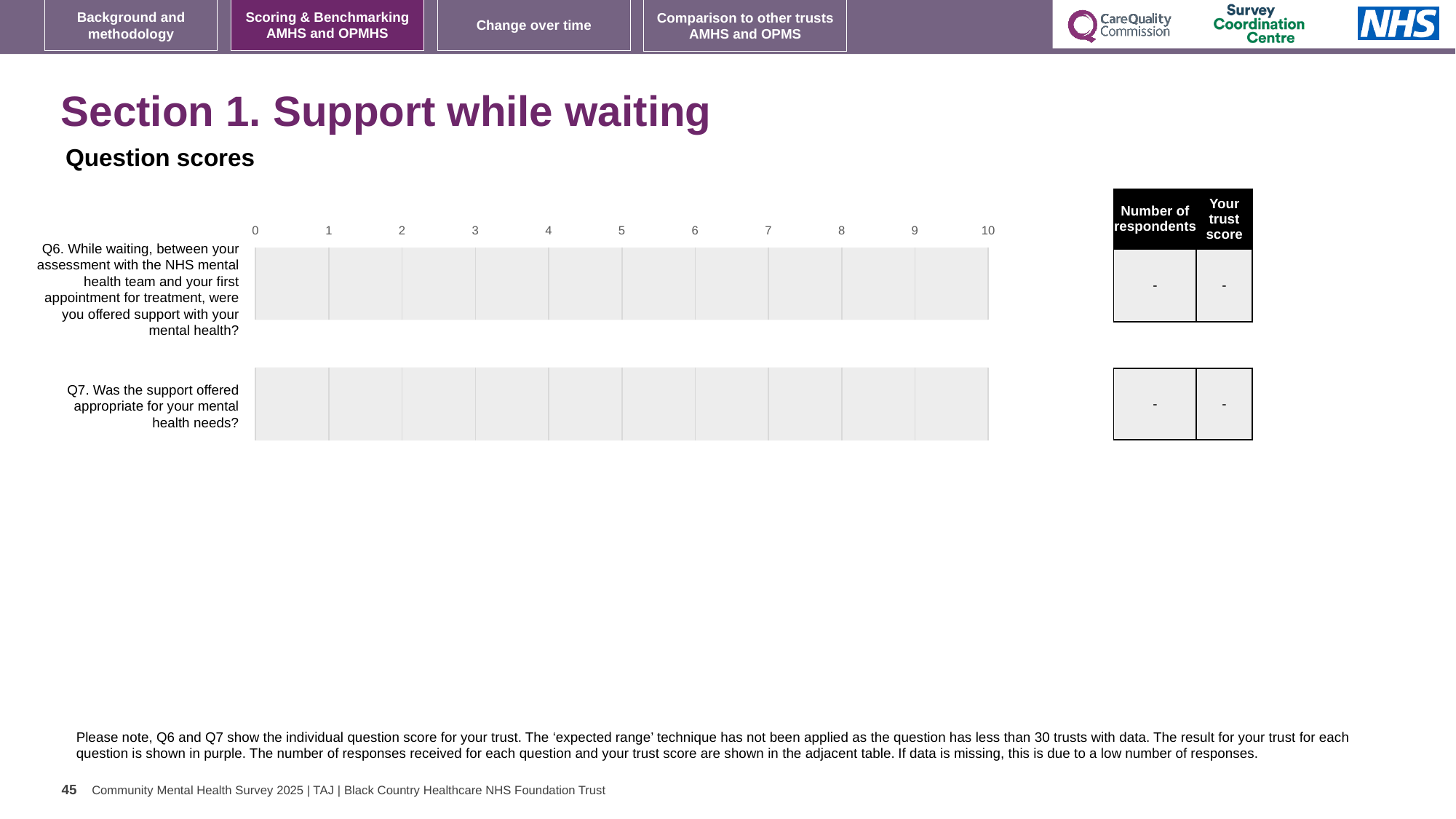
What is the number of respondents shown for Q6 in the table next to the chart? - Which question number is listed first (at the top) on the chart? Q6 What is the trust score shown for Q7 in the table next to the chart? - What is the trust score shown for Q6 in the table next to the chart? - What is the lowest value shown on the chart's horizontal axis? 0 What is the highest value shown on the chart's horizontal axis? 10 How many questions (categories) are listed on the chart? 2 What is the number of respondents shown for Q7 in the table next to the chart? -